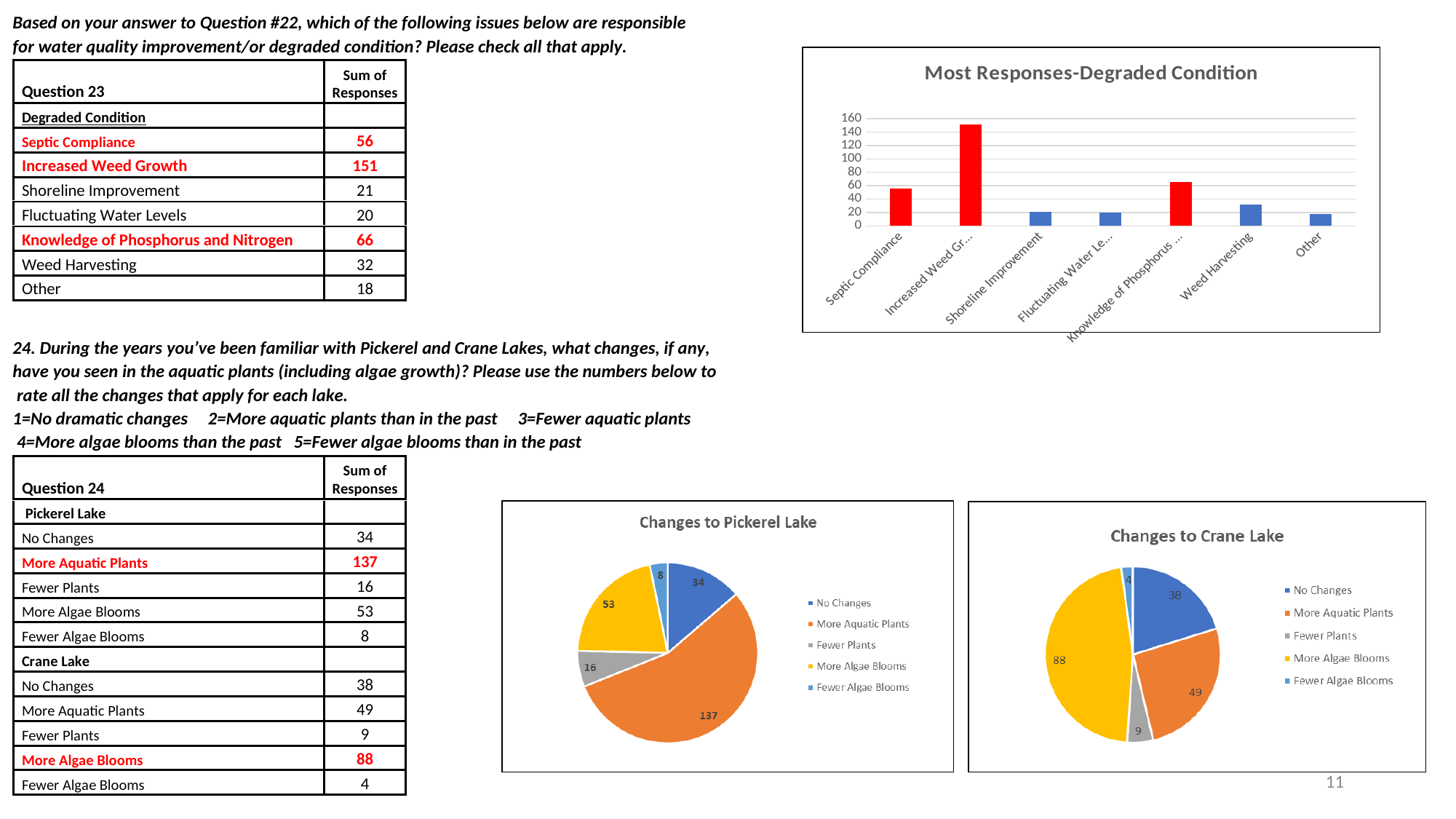
In the "Changes to Pickerel Lake" pie chart, what is the difference between More Aquatic Plants and More Algae Blooms? 84 How many entries does the legend of the "Changes to Crane Lake" pie chart list? 5 In the "Most Responses-Degraded Condition" chart, how many categories are plotted? 7 In the "Most Responses-Degraded Condition" chart, is the value for Weed Harvesting greater or less than 40? less In the "Changes to Pickerel Lake" pie chart, which category has the largest slice? More Aquatic Plants In the "Most Responses-Degraded Condition" chart, is the value for Septic Compliance greater or less than 40? greater In the "Changes to Crane Lake" pie chart, what is the value for More Algae Blooms? 88 What kind of chart is "Most Responses-Degraded Condition"? bar chart In the "Changes to Pickerel Lake" pie chart, what is the value for More Aquatic Plants? 137 In the "Changes to Crane Lake" pie chart, which category has the smallest slice? Fewer Algae Blooms In the "Most Responses-Degraded Condition" chart, which category has the highest value? Increased Weed Growth In the "Most Responses-Degraded Condition" chart, is the value for Increased Weed Growth greater or less than 140? greater